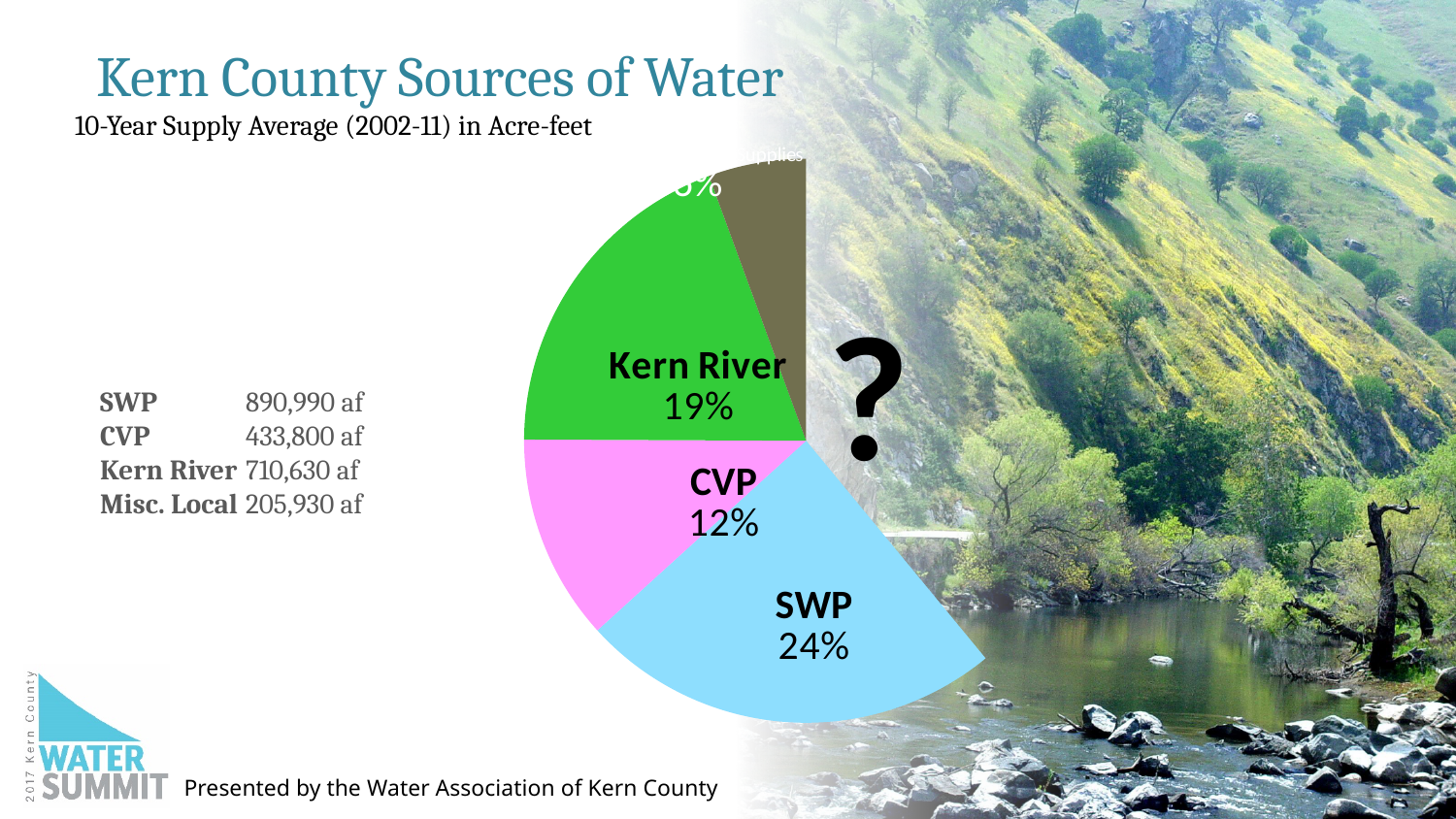
What kind of chart is shown on the slide? pie chart What share of the pie does SWP represent? 24% How many percentage points larger is the SWP share than the CVP share? 12 percentage points What colour is the Kern River slice of the pie chart? green What share of the pie does Kern River represent? 19% Of SWP, CVP and Kern River, which has the largest share of the pie? SWP Which has the larger share of the pie, SWP or CVP? SWP What share of the pie does CVP represent? 12% How many percentage points larger is the SWP share than the Kern River share? 5 percentage points Of SWP, CVP and Kern River, which has the smallest share of the pie? CVP Which has the larger share of the pie, Kern River or CVP? Kern River What is the title of the slide containing the pie chart? Kern County Sources of Water